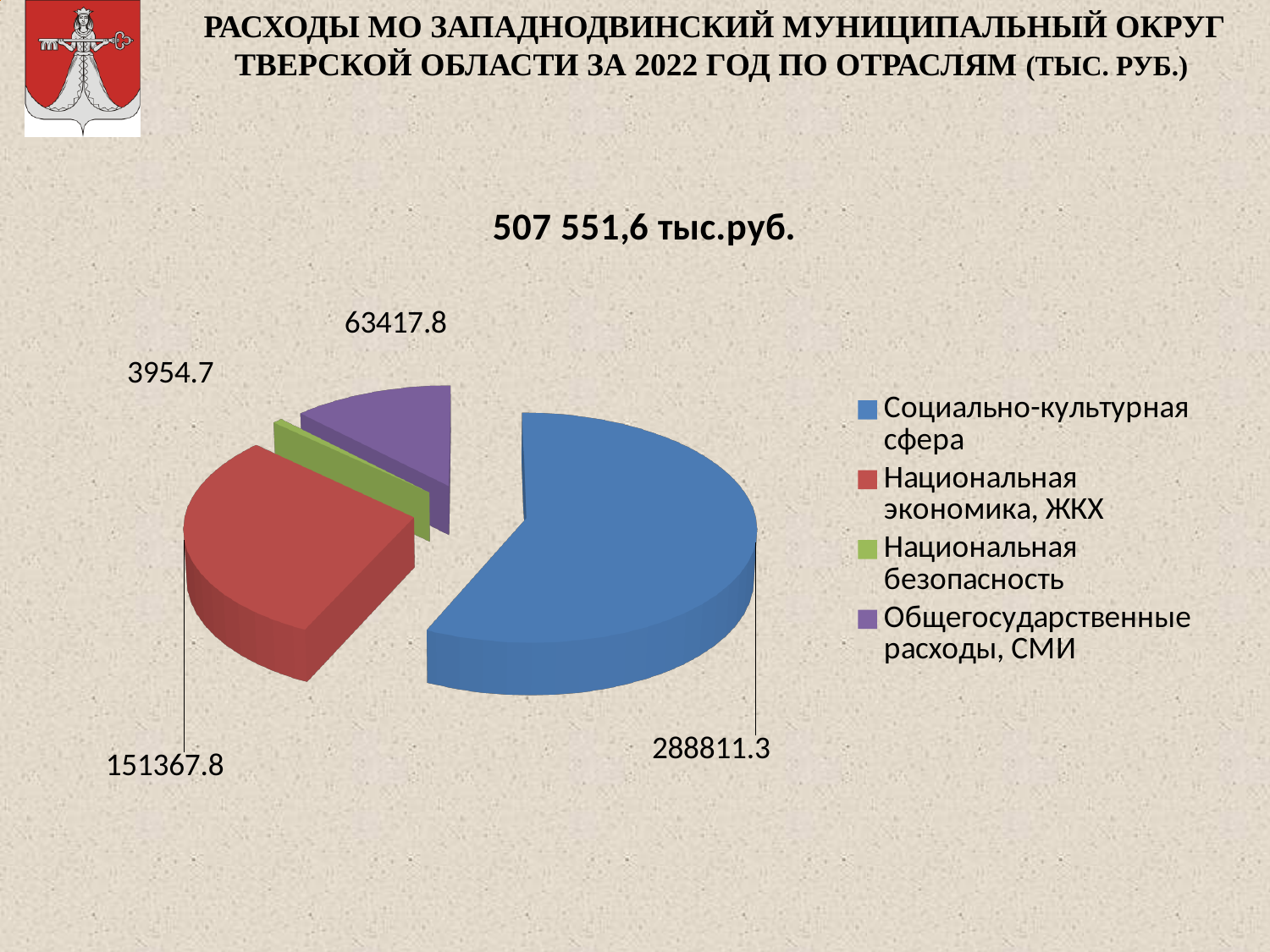
How many categories does the pie chart show? 4 What type of chart is shown on the slide? Pie chart What is the value for Общегосударственные расходы, СМИ? 63417.8 Which category has the smallest value? Национальная безопасность What is the value for Национальная экономика, ЖКХ? 151367.8 What is the value for Социально-культурная сфера? 288811.3 What is the difference between the values for Социально-культурная сфера and Национальная экономика, ЖКХ? 137443.5 Which is larger: Национальная экономика, ЖКХ or Общегосударственные расходы, СМИ? Национальная экономика, ЖКХ What total amount is shown above the pie chart? 507 551,6 тыс.руб. What is the value for Национальная безопасность? 3954.7 Which category has the largest value? Социально-культурная сфера What is the difference between the values for Общегосударственные расходы, СМИ and Национальная безопасность? 59463.1